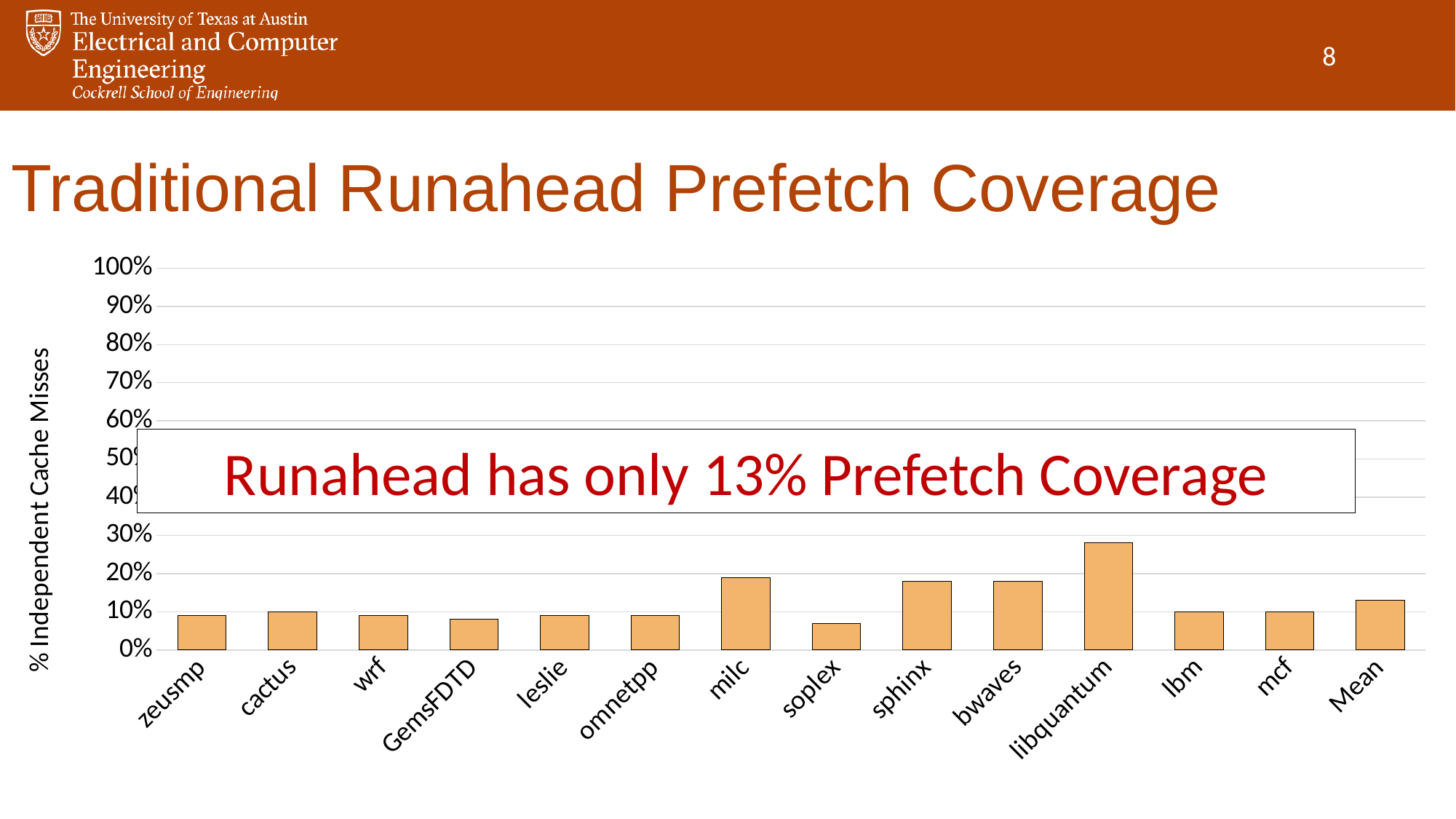
What is the label of the vertical axis? % Independent Cache Misses Is the value for soplex greater or less than 10%? less Is the value for zeusmp greater or less than 20%? less What kind of chart is shown on the slide? bar chart Which category has the highest bar on the chart? libquantum Is the value for milc greater or less than 10%? greater Which is larger, the value for libquantum or the value for sphinx? libquantum How many categories (bars) are plotted on the chart? 14 What is the title of the slide containing the chart? Traditional Runahead Prefetch Coverage Which is larger, the value for milc or the value for wrf? milc